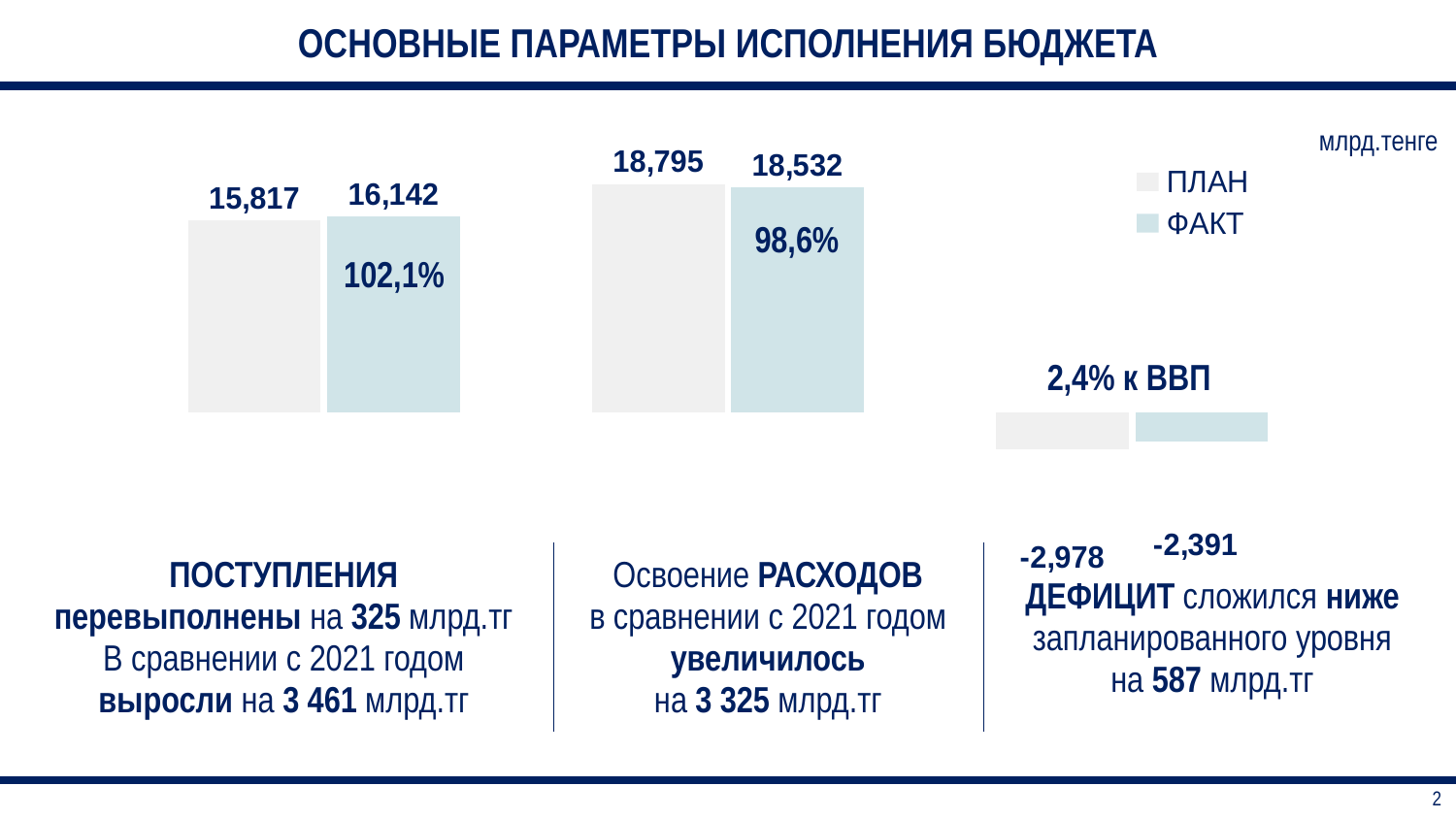
What unit of measurement is indicated for the charts on the slide? млрд.тенге In the right chart (ДЕФИЦИТ), what is the value of the ФАКТ bar? -2,391 In the middle chart (РАСХОДОВ), what is the value of the ПЛАН bar? 18,795 How many series does the legend list? 2 In the middle chart (РАСХОДОВ), which bar is higher, ПЛАН or ФАКТ? ПЛАН In the middle chart (РАСХОДОВ), what is the value of the ФАКТ bar? 18,532 In the left chart (ПОСТУПЛЕНИЯ), what is the value of the ПЛАН bar? 15,817 In the left chart (ПОСТУПЛЕНИЯ), which bar is higher, ПЛАН or ФАКТ? ФАКТ In the middle chart (РАСХОДОВ), what is the difference between the ПЛАН and ФАКТ values? 263 What type of chart is used on the slide? Bar chart In the right chart (ДЕФИЦИТ), what is the value of the ПЛАН bar? -2,978 In the left chart (ПОСТУПЛЕНИЯ), what is the value of the ФАКТ bar? 16,142